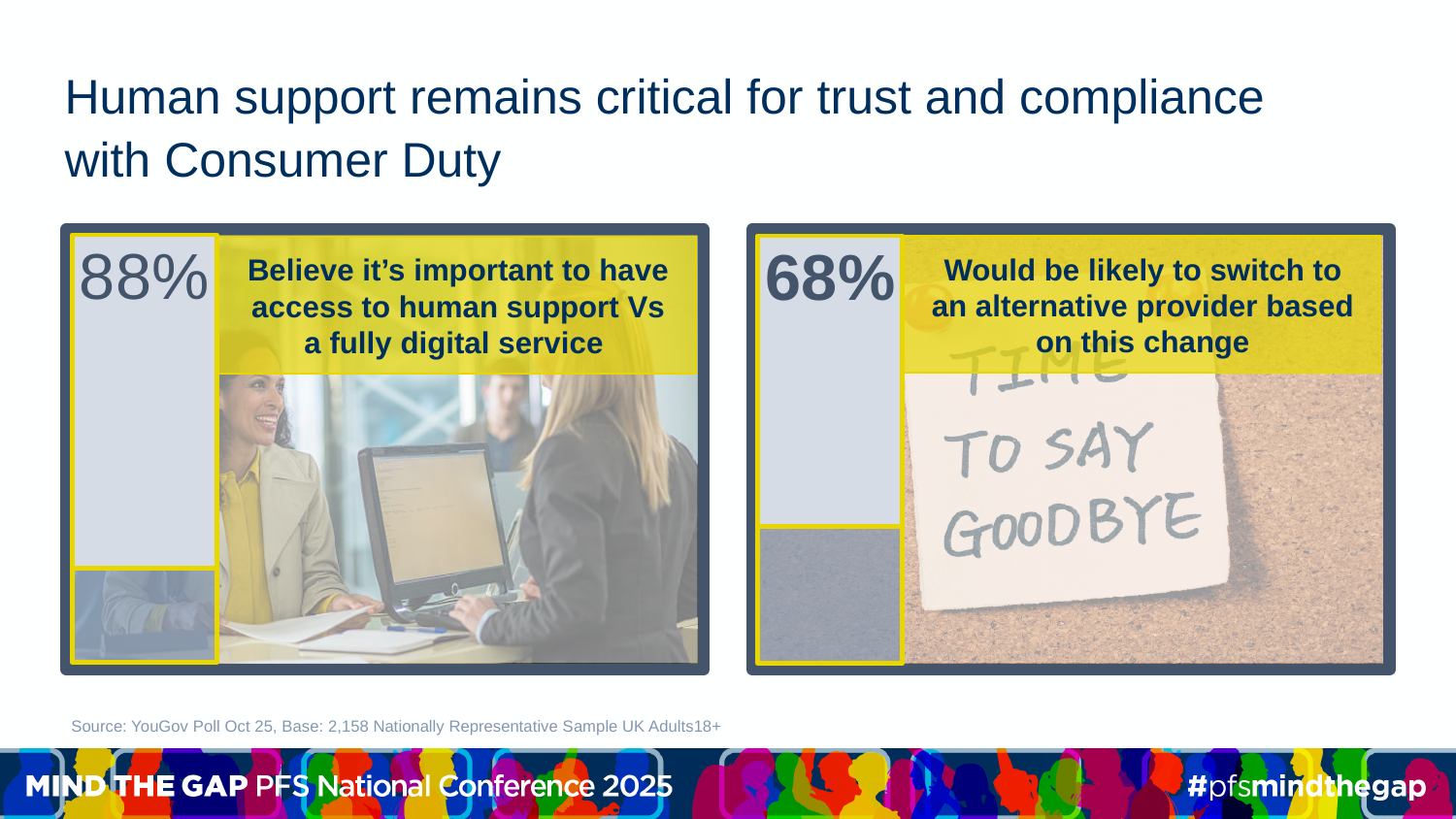
Is the value on the left chart greater or less than 50%? greater What is the difference in percentage points between the left chart value (88%) and the right chart value (68%)? 20 percentage points What kind of chart is used to show each percentage on the slide? Bar chart (single filled bar) How many percentage statistics are shown on the slide? 2 Is the value on the right chart greater or less than 70%? less On the right chart, what percentage would be likely to switch to an alternative provider based on this change? 68% On the left chart, what percentage believe it's important to have access to human support vs a fully digital service? 88% What is the title of the slide containing the two charts? Human support remains critical for trust and compliance with Consumer Duty What is the base sample size cited in the source line for the charts? 2,158 Which is larger: the percentage who believe access to human support is important (left chart) or the percentage likely to switch provider (right chart)? Believe access to human support is important (88%)